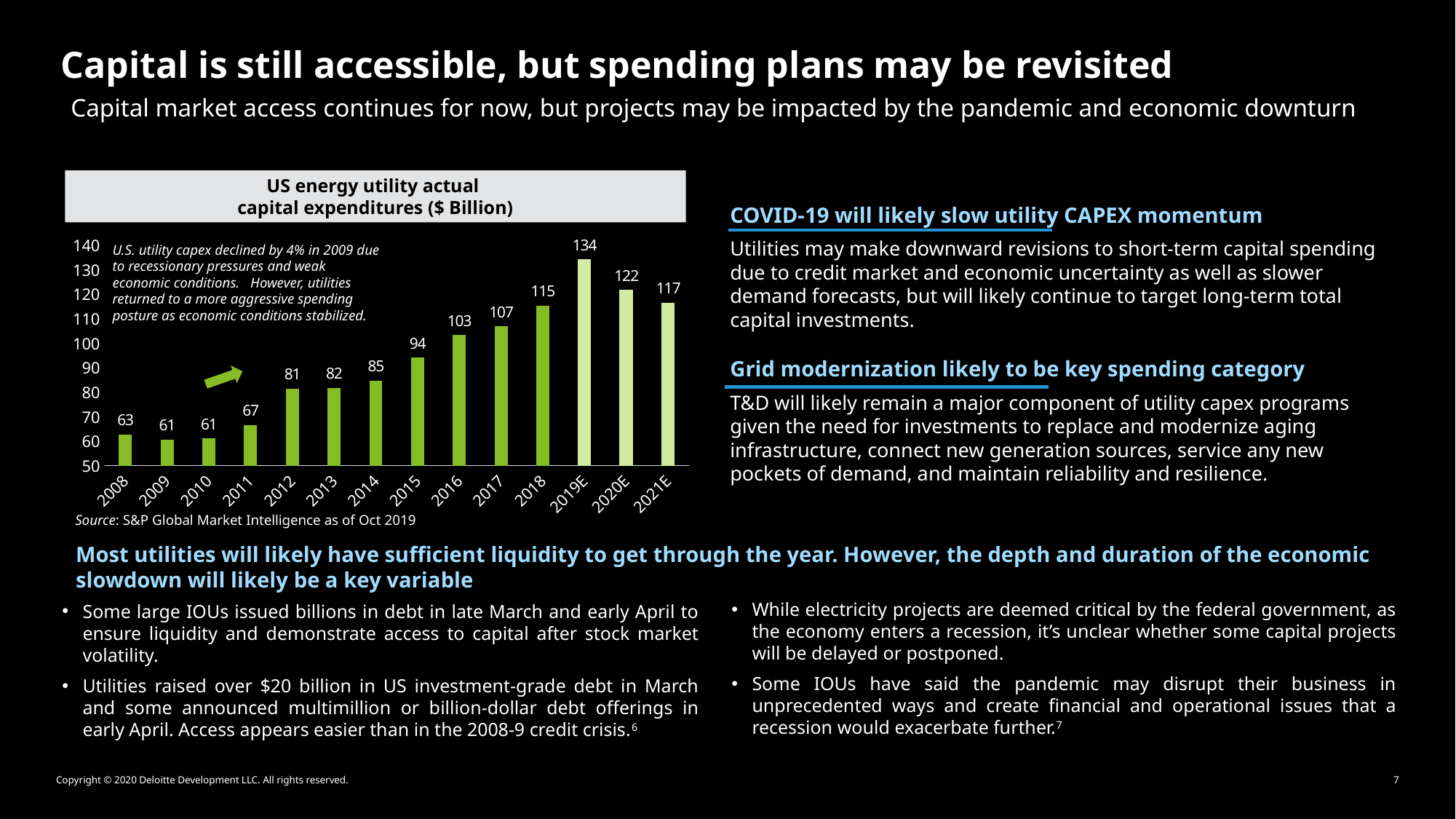
What is the value for 2019E in the capital expenditures chart? 134 Do the capital expenditure values generally rise or fall from 2010 to 2019E? rise Which years share the lowest capital expenditure value in the chart? 2009 and 2010 What is the value for 2018 in the US energy utility actual capital expenditures chart? 115 What is the value for 2008 in the capital expenditures chart? 63 What kind of chart is used to show US energy utility actual capital expenditures? bar chart What is the difference between the 2019E and 2020E values in the capital expenditures chart? 12 What is the title of the chart on the slide? US energy utility actual capital expenditures ($ Billion) How many years are shown on the x axis of the capital expenditures chart? 14 Which is larger in the capital expenditures chart, the value for 2015 or the value for 2016? 2016 Which year has the highest capital expenditure value in the chart? 2019E Is the value for 2021E in the capital expenditures chart greater or less than 100? greater